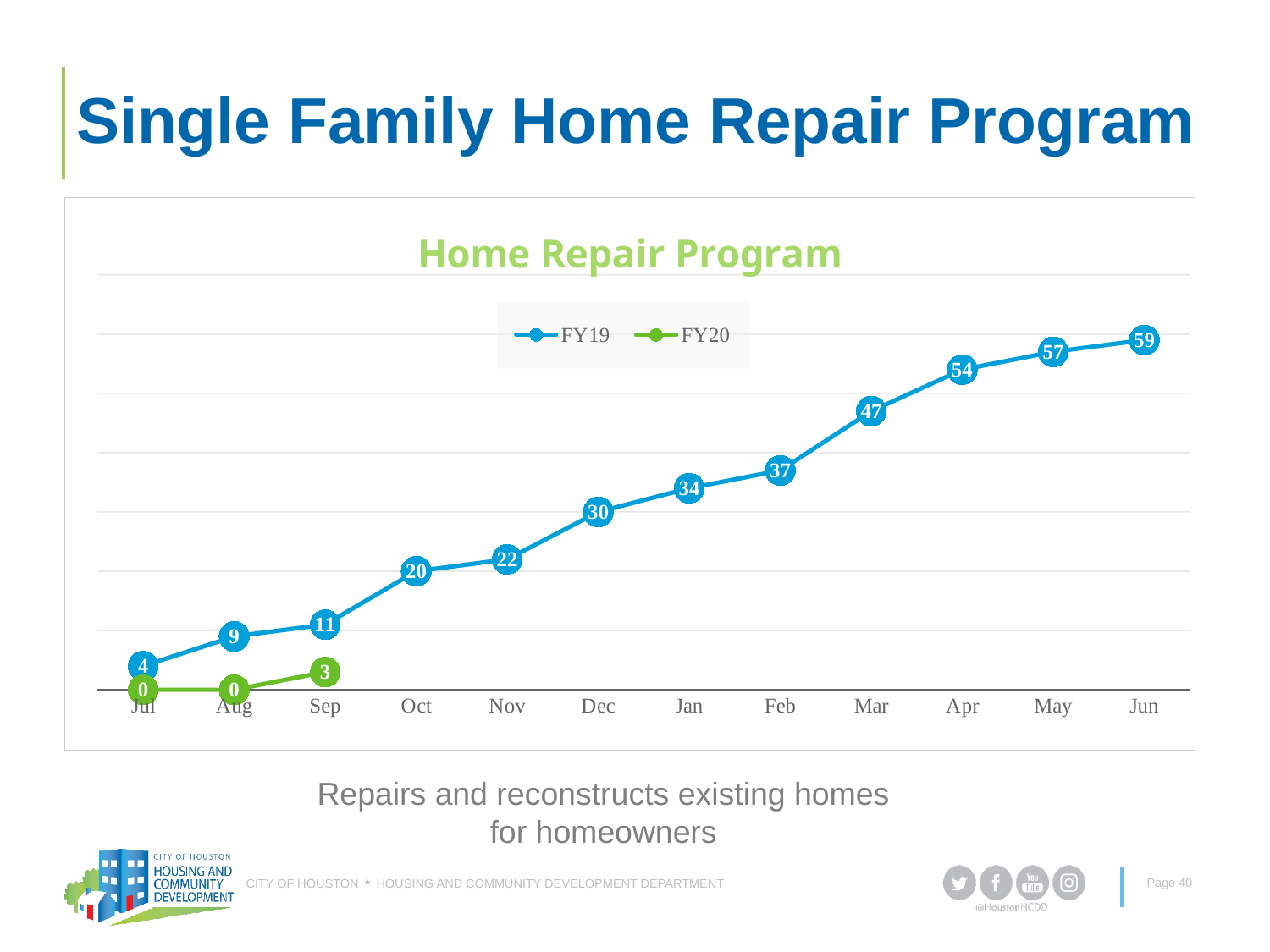
What kind of chart is this? Line chart How many series does the legend list? 2 Which month has the lowest FY19 value? Jul What is the FY19 value for Jun? 59 Do the FY19 values rise or fall from Jul to Jun? Rise What is the FY20 value for Sep? 3 Which is larger, the FY19 value for Sep or the FY20 value for Sep? FY19 What is the FY19 value for Dec? 30 How many months are shown on the x axis? 12 What is the title of the chart? Home Repair Program What is the difference between the FY19 values for Mar and Feb? 10 Which month has the highest FY19 value? Jun